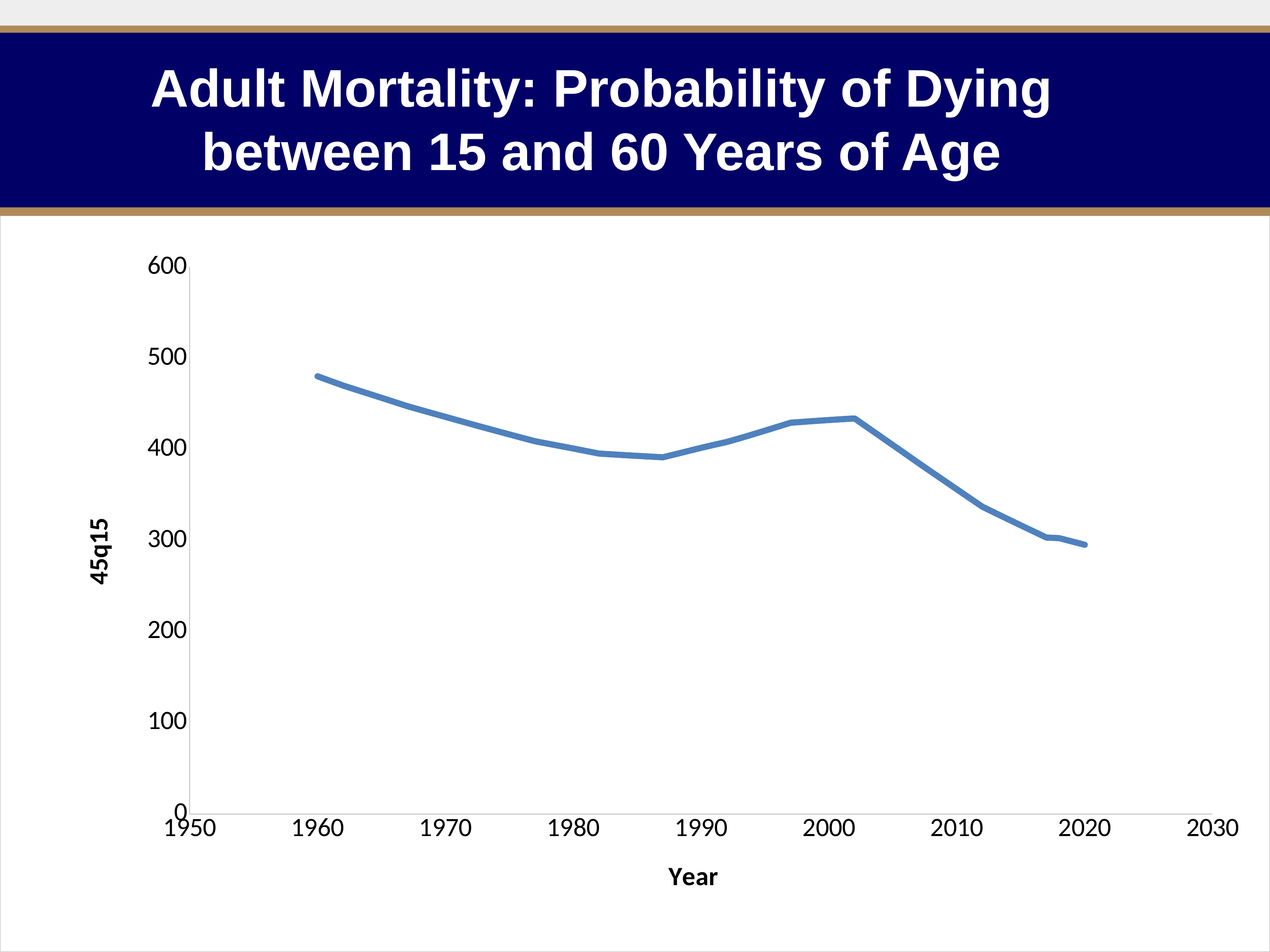
Is the value for 2010 greater or less than 300? greater Is the value for 1960 greater or less than 400? greater Overall, does the plotted value rise or fall from 1960 to 2020? fall Is the value for 1970 greater or less than 400? greater What is the label on the vertical axis of the chart? 45q15 In which year shown does the line reach its highest value? 1960 Which year has the larger value, 1960 or 2020? 1960 In which year shown does the line reach its lowest value? 2020 What kind of chart is shown on the slide? line chart